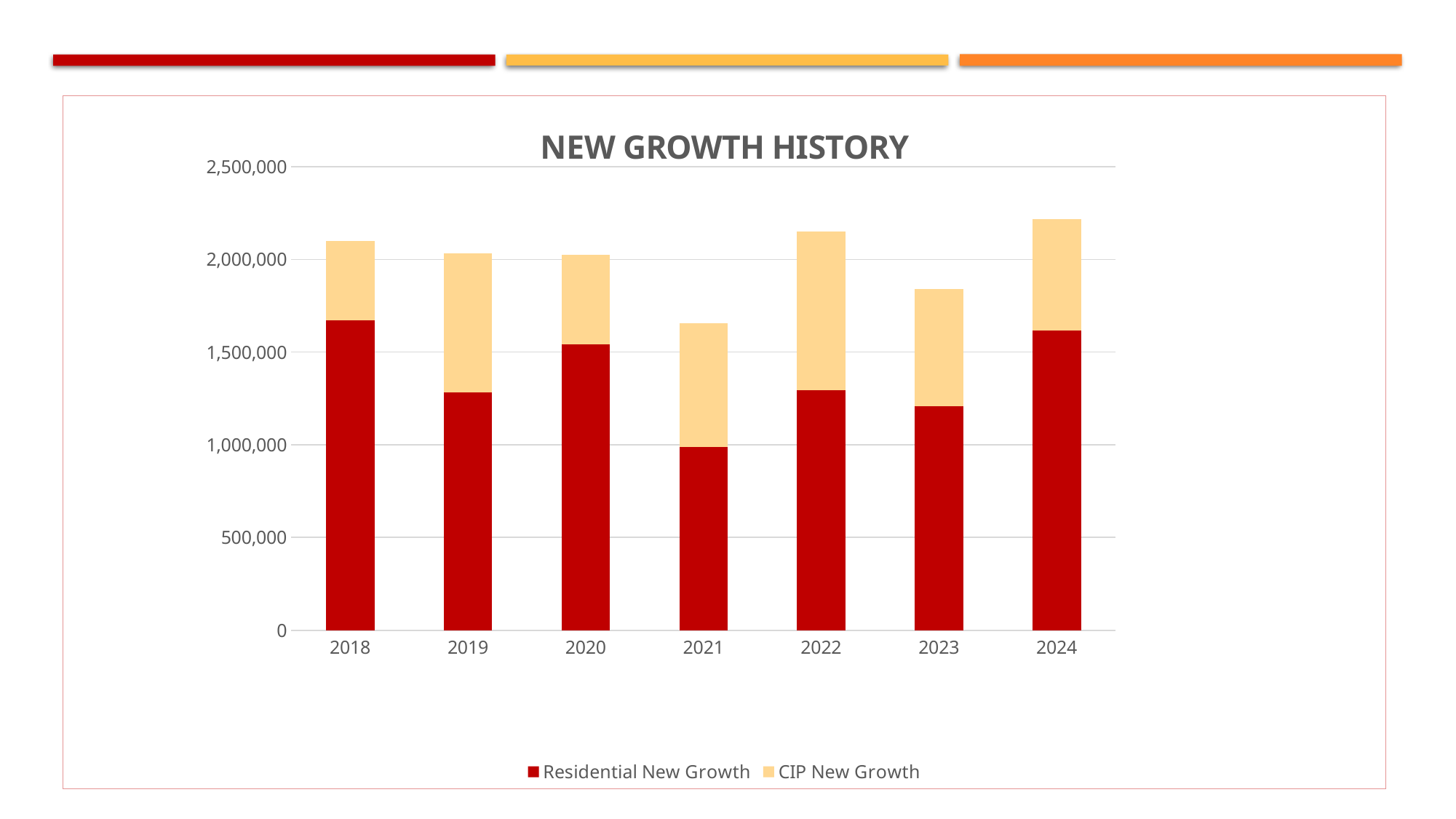
Which year has the larger Residential New Growth, 2018 or 2019? 2018 Is the Residential New Growth for 2018 greater or less than 1,500,000? greater Which year has the lowest Residential New Growth? 2021 What kind of chart is shown on the slide? Stacked bar chart What is the title of the chart? NEW GROWTH HISTORY Which year has the highest total new growth? 2024 How many series does the legend list? 2 Is the total new growth for 2023 greater or less than 2,000,000? less Which series is shown in dark red? Residential New Growth Which year has the lowest total new growth? 2021 How many years are shown on the x axis? 7 Is the Residential New Growth for 2019 greater or less than 1,500,000? less